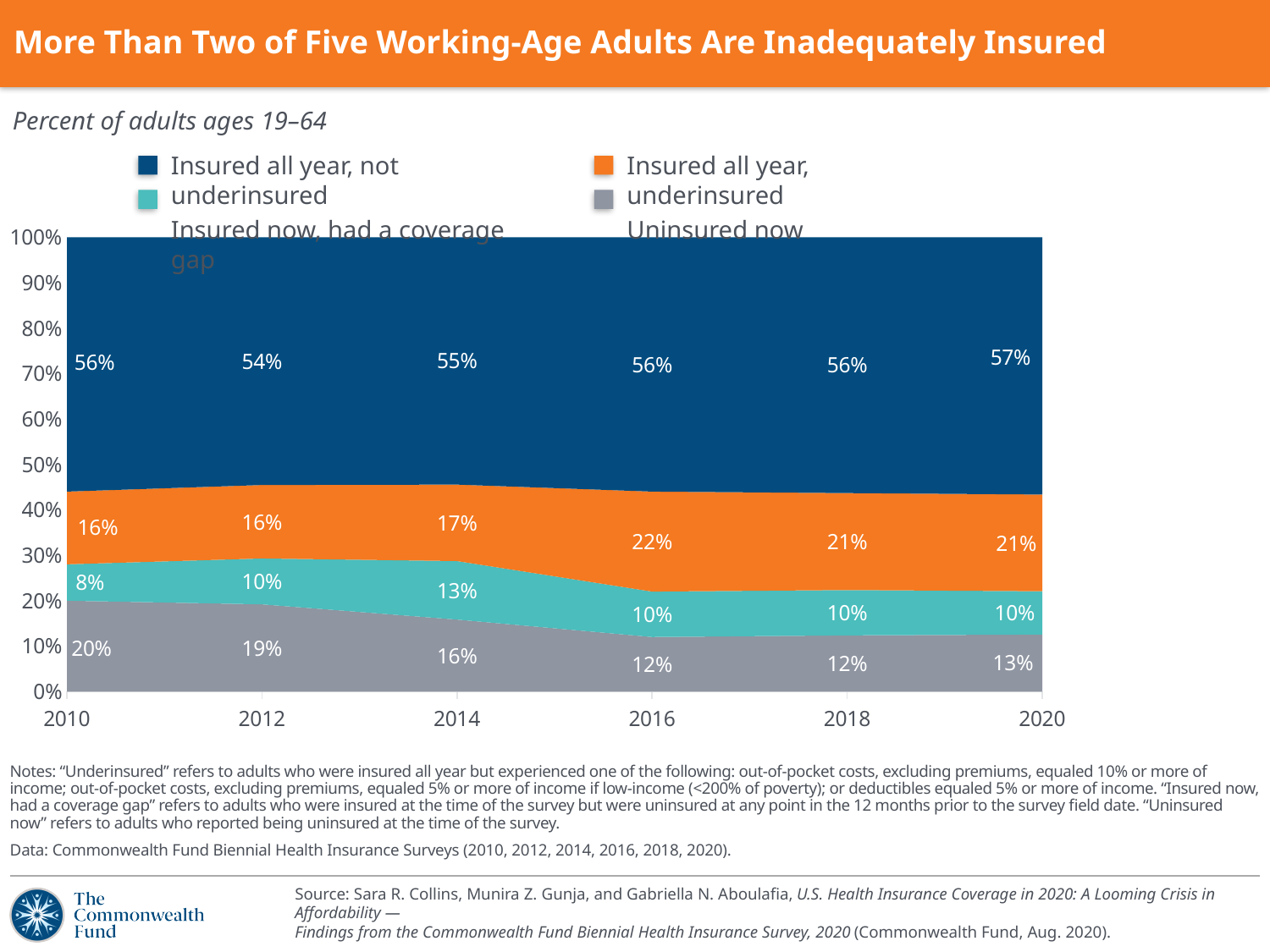
By how many percentage points did the share of adults uninsured now change from 2010 to 2020? 7 percentage points How many years are shown on the x axis? 6 In which year was the share of adults uninsured now the highest? 2010 In which year was the share of adults insured all year, not underinsured the lowest? 2012 Which was larger in 2014: the share insured all year, underinsured or the share uninsured now? Insured all year, underinsured What percentage of adults were uninsured now in 2010? 20% What percentage of adults were insured now, had a coverage gap in 2014? 13% Did the share of adults uninsured now generally rise or fall from 2010 to 2018? Fall What kind of chart is shown on the slide? Stacked area chart What percentage of adults were insured all year, underinsured in 2016? 22% How many series does the legend list? 4 What percentage of adults were insured all year, not underinsured in 2020? 57%